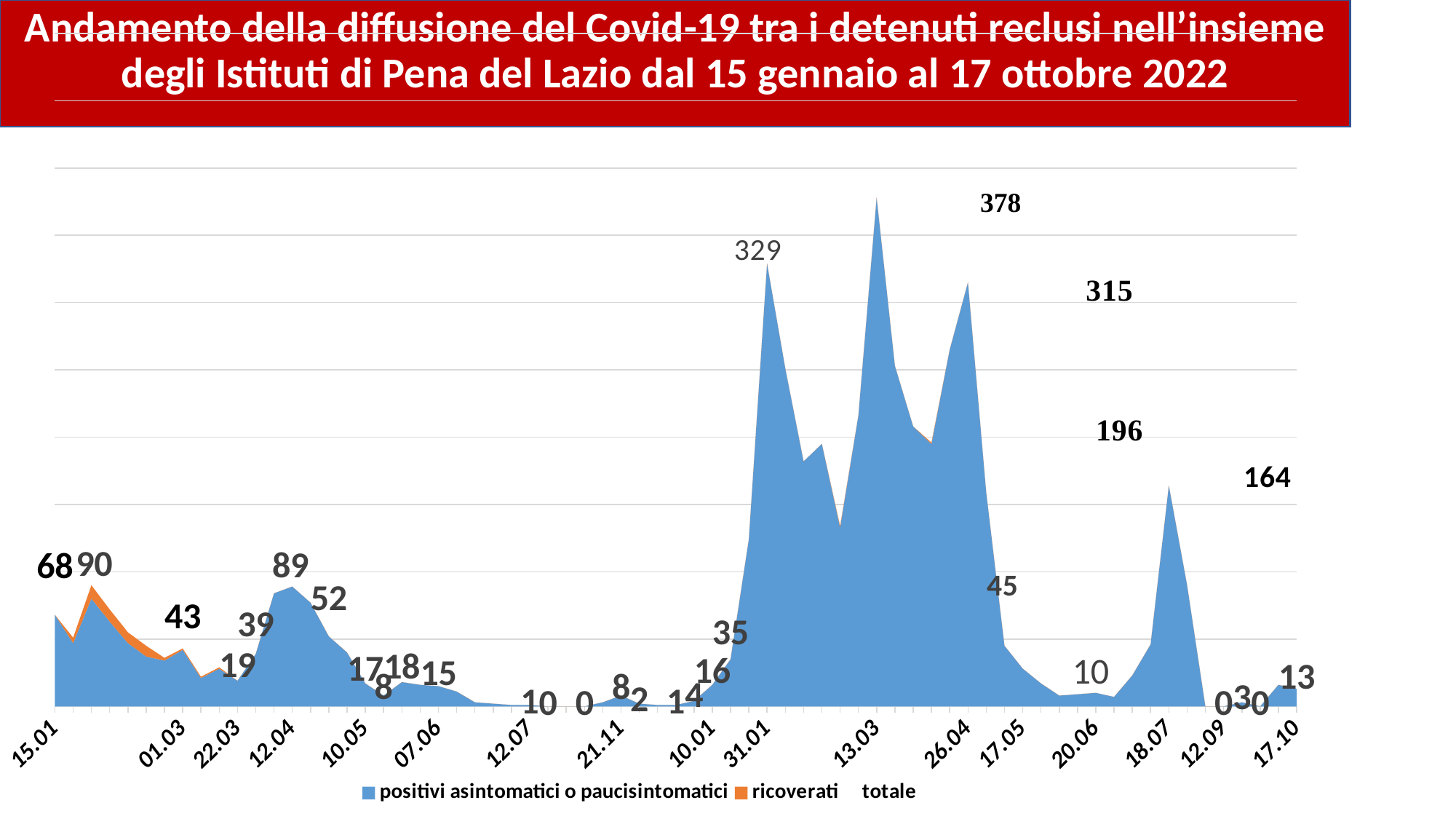
What is the value labelled at the first date, 15.01? 68 Which is larger, the value labelled at 31.01 or the peak value near 13.03? the peak near 13.03 (378) Do the values rise or fall between 12.04 and 12.07? fall What is the value labelled at 31.01? 329 How many date labels are shown on the x axis? 17 What is the value labelled at the last date, 17.10? 13 What is the value labelled at 12.04? 89 What type of chart is shown on the slide? area chart What is the highest data label shown on the chart? 378 How many series does the legend list? 3 Which colour represents the 'ricoverati' series in the legend? orange What is the difference between the peak value 378 and the value labelled at 31.01? 49